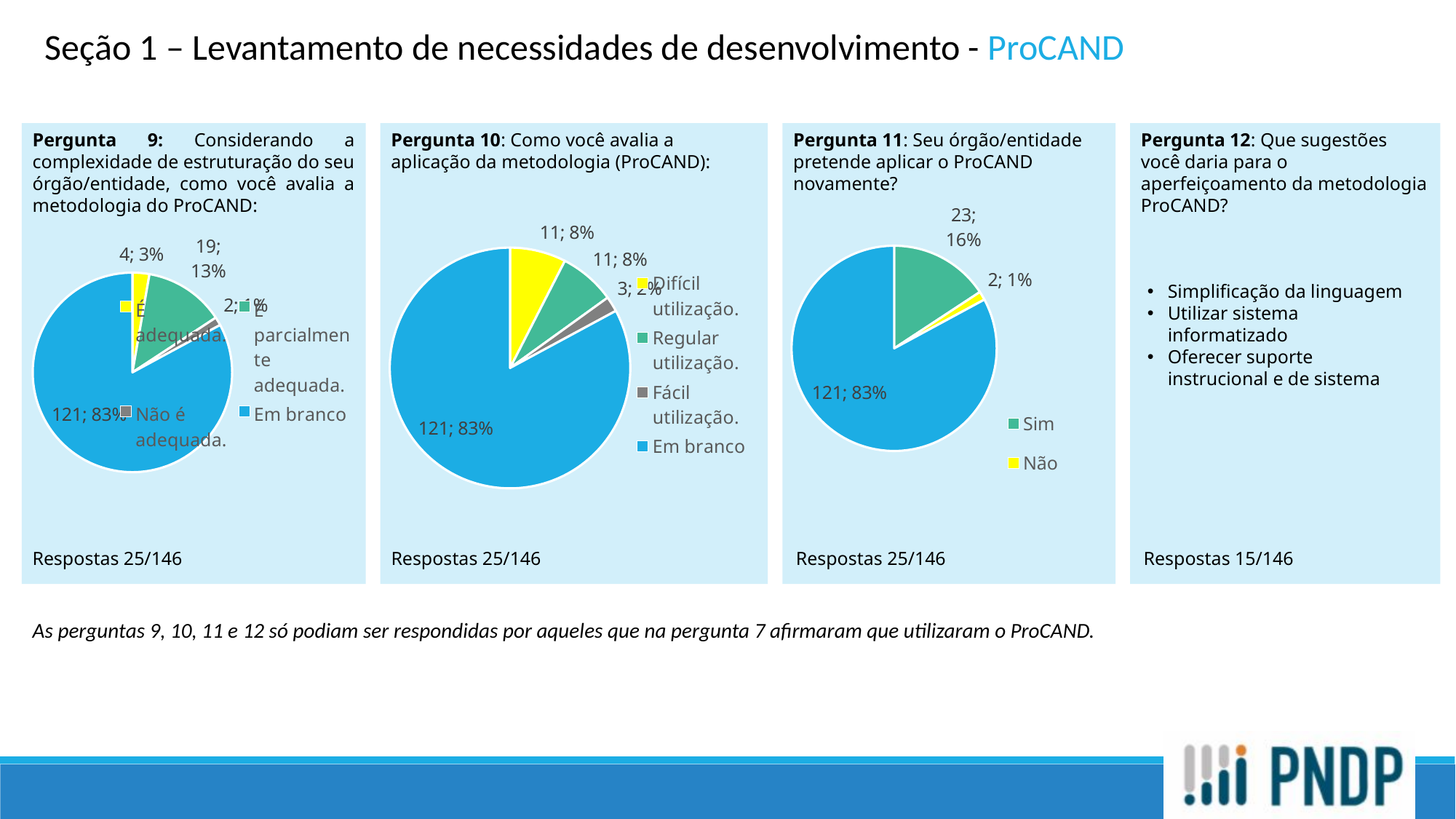
In the Pergunta 11 chart, what value is shown for the 'Sim' slice? 23; 16% In the Pergunta 10 chart, what share of the pie does 'Difícil utilização' represent? 8% In the Pergunta 9 chart, what value is shown for the 'É parcialmente adequada' slice? 19; 13% In the Pergunta 9 chart, how many categories does the legend list? 4 What kind of chart is used for Pergunta 10? Pie chart In the Pergunta 11 chart, how many entries does the legend list? 2 In the Pergunta 11 chart, what colour is the 'Não' slice? Yellow In the Pergunta 9 chart, which category has the smallest slice? Não é adequada In the Pergunta 10 chart, what is the difference in count between 'Em branco' and 'Regular utilização'? 110 In the Pergunta 9 chart, what value is shown for the 'Em branco' slice? 121; 83% In the Pergunta 11 chart, which is larger, 'Sim' or 'Não'? Sim In the Pergunta 10 chart, what value is shown for the 'Fácil utilização' slice? 3; 2%